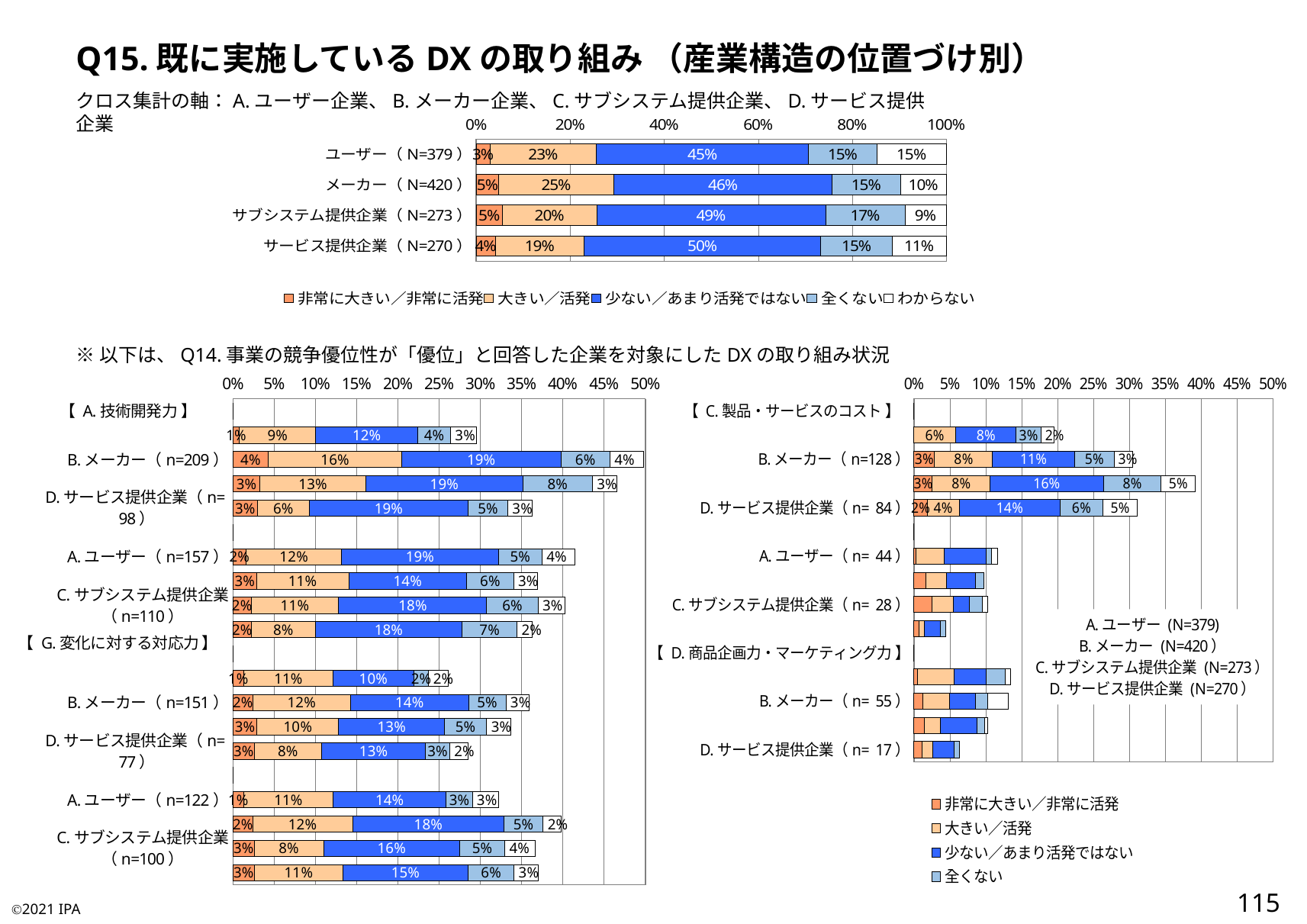
How many categories (bars) does the top chart show? 4 How many series does the legend of the top chart list? 5 In the top chart, what percentage of ユーザー (N=379) answered 少ない／あまり活発ではない? 45% In the top chart, what percentage of サービス提供企業 (N=270) answered 少ない／あまり活発ではない? 50% What type of chart is the top chart? Stacked bar chart In the top chart, which category has the highest share of 少ない／あまり活発ではない? サービス提供企業 (N=270) In the top chart, what is the difference between the わからない share for ユーザー (N=379) and for メーカー (N=420)? 5% In the bottom-right chart, what percentage of B. メーカー (n=128) answered 少ない／あまり活発ではない? 11% In the top chart, which category has the lowest share of わからない? サブシステム提供企業 (N=273) In the top chart, which is larger: the 大きい／活発 share for ユーザー (N=379) or for サブシステム提供企業 (N=273)? ユーザー (N=379) In the bottom-left chart, what percentage of B. メーカー (n=209) answered 少ない／あまり活発ではない? 19% In the top chart, what percentage of メーカー (N=420) answered 大きい／活発? 25%